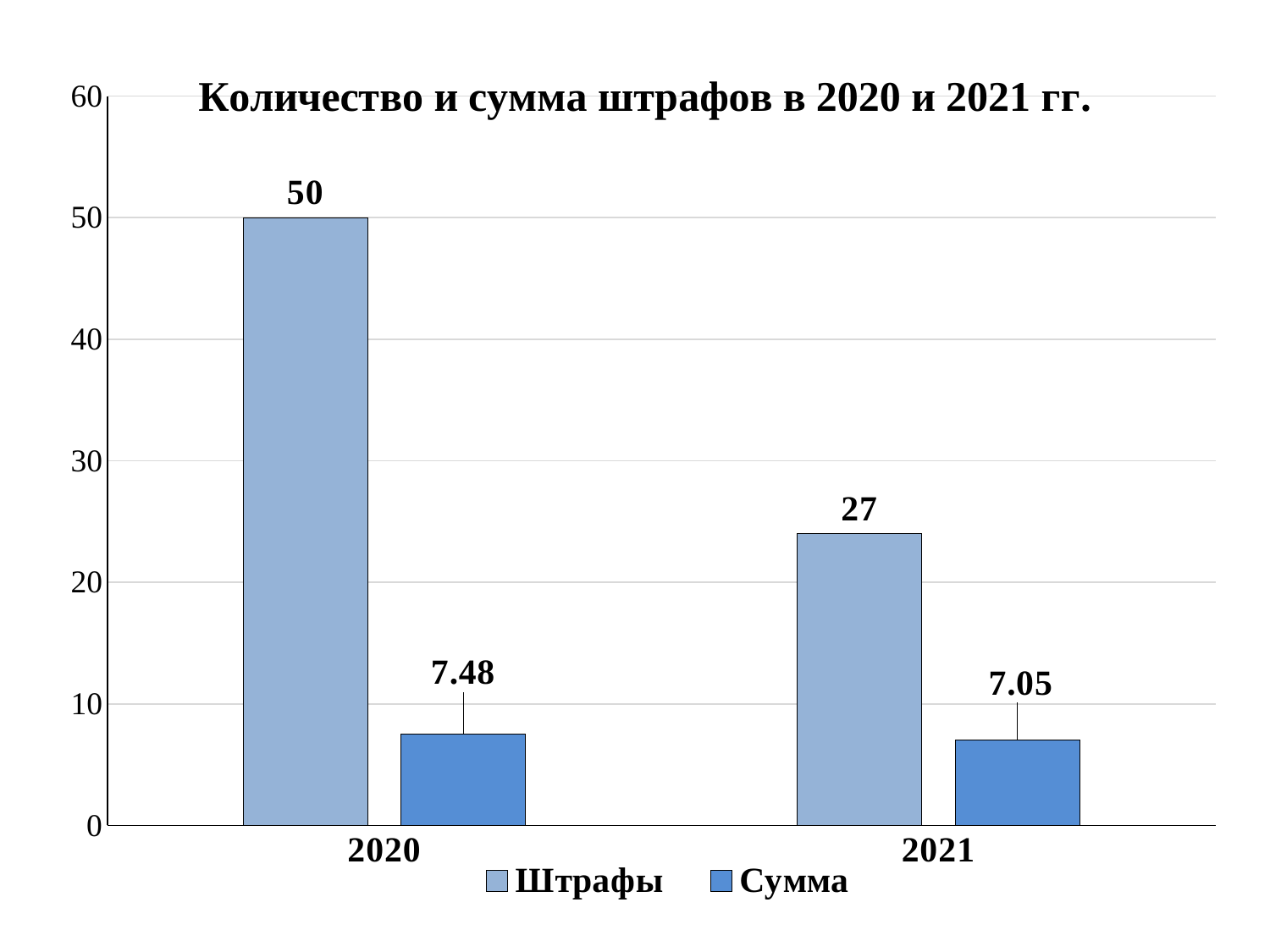
What is the value of Штрафы for 2020? 50 What is the difference between the Штрафы values for 2020 and 2021? 23 What is the title of the chart? Количество и сумма штрафов в 2020 и 2021 гг. What is the value of Сумма for 2021? 7.05 What is the value of Штрафы for 2021? 27 What is the value of Сумма for 2020? 7.48 Which is larger: Сумма for 2020 or Сумма for 2021? Сумма for 2020 What kind of chart is shown on the slide? bar chart How many series does the legend list? 2 Is the value of Штрафы for 2021 greater or less than 20? greater How many years are shown on the x axis? 2 Which year has the higher value for Штрафы? 2020